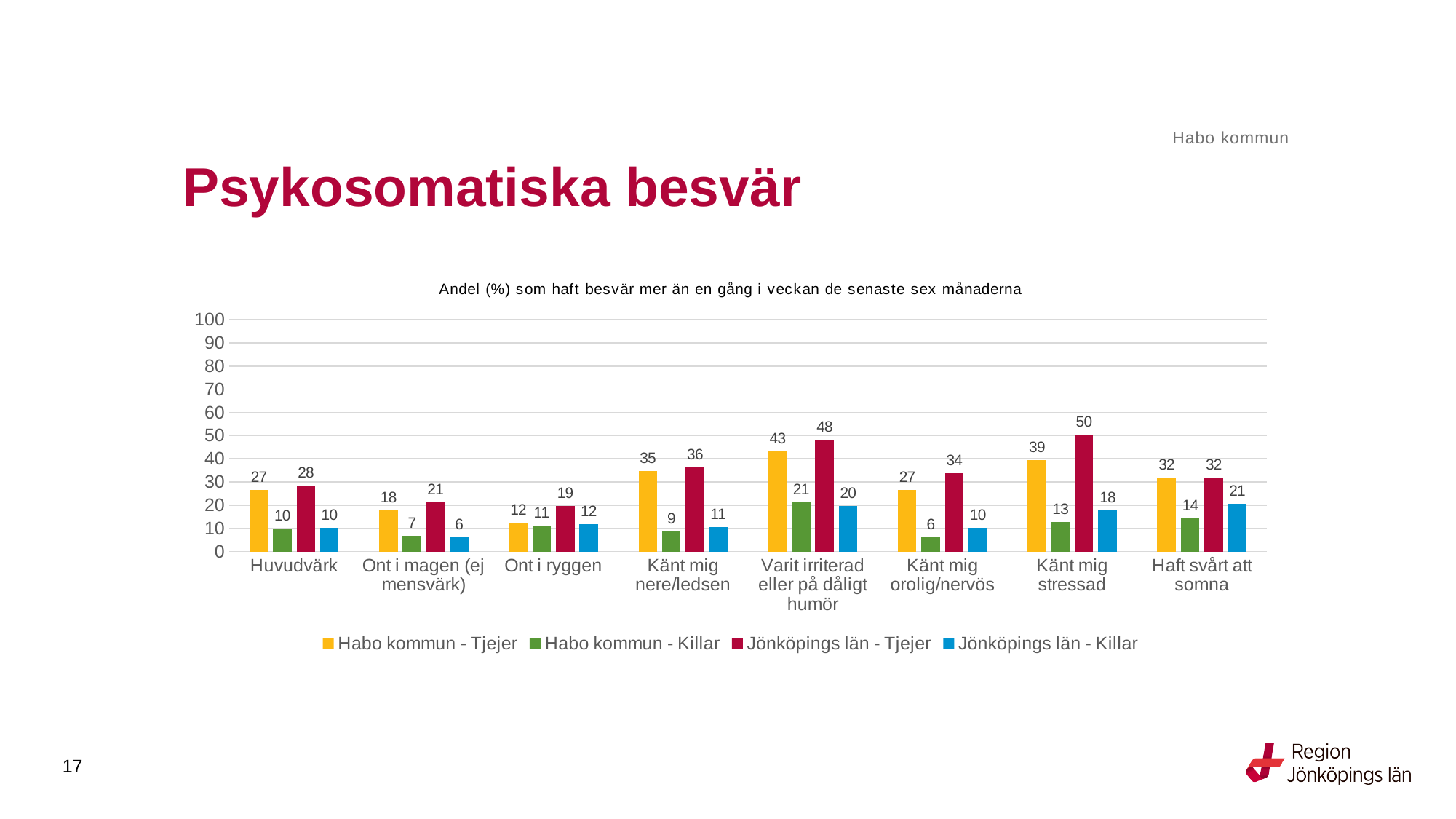
Which category has the highest value for Habo kommun - Tjejer? Varit irriterad eller på dåligt humör What kind of chart is shown on the slide? Bar chart What is the value for Habo kommun - Tjejer for Huvudvärk? 27 What is the value for Jönköpings län - Killar for Haft svårt att somna? 21 What is the value for Habo kommun - Killar for Varit irriterad eller på dåligt humör? 21 Which is larger for Känt mig orolig/nervös: Habo kommun - Killar or Jönköpings län - Killar? Jönköpings län - Killar Which category has the lowest value for Jönköpings län - Killar? Ont i magen (ej mensvärk) What is the title of the chart? Andel (%) som haft besvär mer än en gång i veckan de senaste sex månaderna What is the value for Jönköpings län - Tjejer for Känt mig stressad? 50 How many categories are shown on the x axis? 8 How many series does the legend list? 4 What is the difference between Jönköpings län - Tjejer and Habo kommun - Tjejer for Känt mig stressad? 11